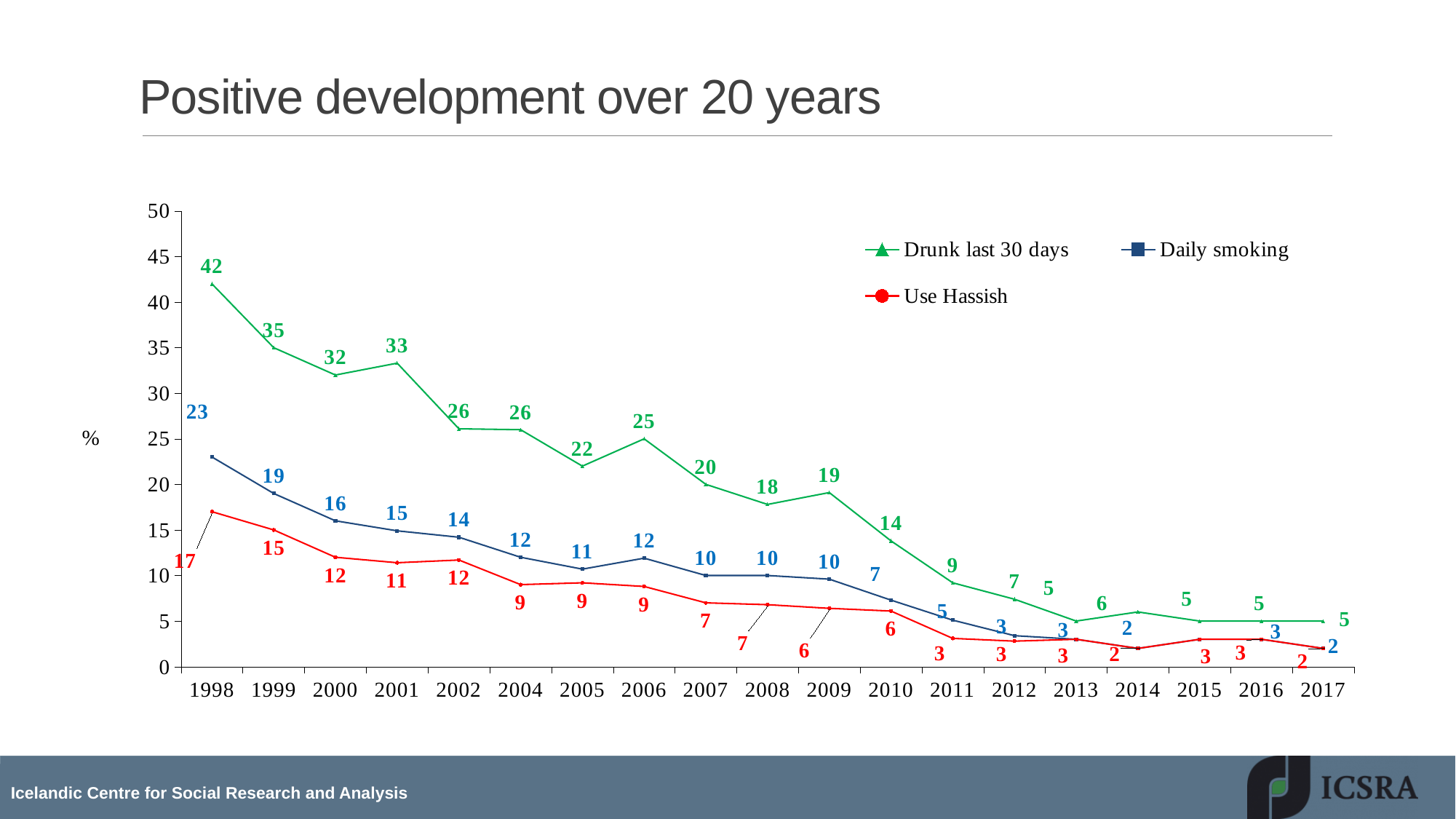
What is the difference between the Drunk last 30 days values in 1998 and 2017? 37 What is the value for Use Hassish in 2010? 6 What is the value for Drunk last 30 days in 1998? 42 In 1998, how much higher is Daily smoking than Use Hassish? 6 Does the Drunk last 30 days series generally rise or fall from 1998 to 2017? fall What kind of chart is shown on the slide? line chart What is the label on the y axis? % How many years are shown on the x axis? 19 In which year is the Drunk last 30 days series at its highest? 1998 In 2006, which is larger: Drunk last 30 days or Daily smoking? Drunk last 30 days What is the value for Daily smoking in 2004? 12 How many series does the legend list? 3